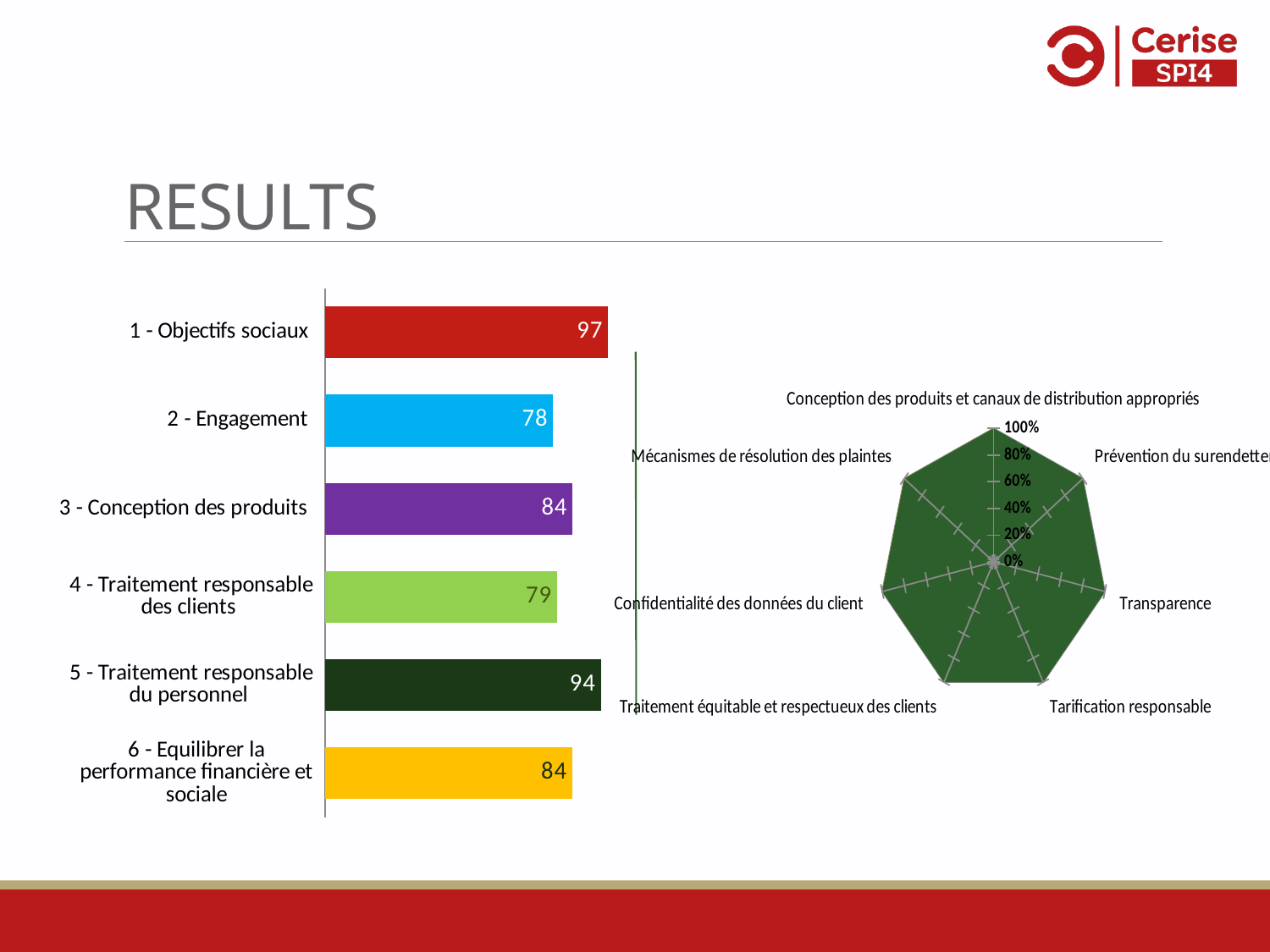
In the bar chart on the left, how many categories are shown? 6 In the radar chart on the right, what is the highest percentage shown on the axis scale? 100% In the bar chart on the left, what is the value for 5 - Traitement responsable du personnel? 94 What kind of chart is the chart on the left of the slide? Bar chart In the bar chart on the left, which is larger: the value for 4 - Traitement responsable des clients or the value for 5 - Traitement responsable du personnel? 5 - Traitement responsable du personnel In the bar chart on the left, what is the value for 1 - Objectifs sociaux? 97 In the bar chart on the left, what is the difference between the values for 1 - Objectifs sociaux and 2 - Engagement? 19 In the bar chart on the left, what is the value for 2 - Engagement? 78 In the bar chart on the left, which category has the highest value? 1 - Objectifs sociaux In the radar chart on the right, is the value for Transparence greater or less than 60%? greater In the bar chart on the left, what colour is the bar for 3 - Conception des produits? Purple In the bar chart on the left, which category has the lowest value? 2 - Engagement